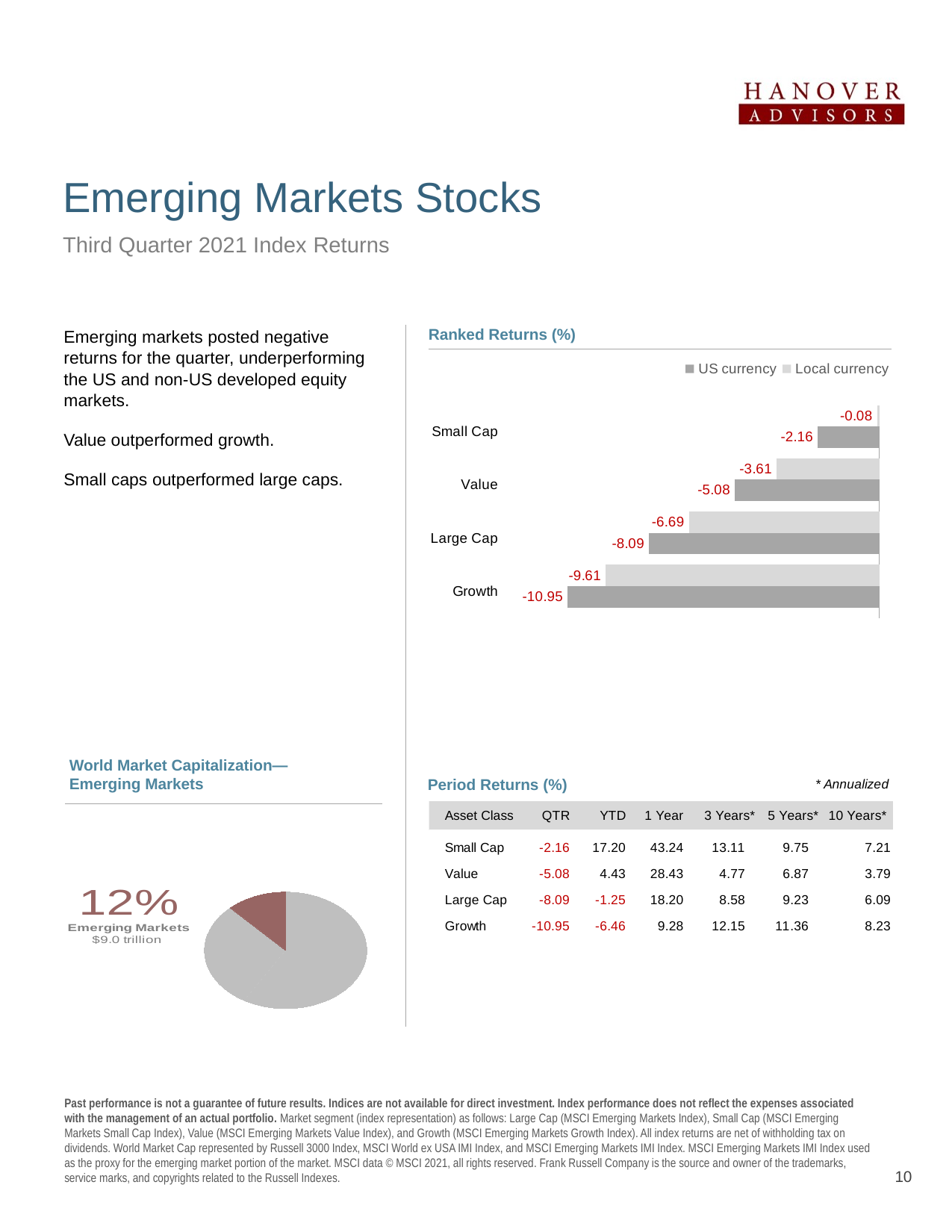
In the Ranked Returns (%) chart, what is the US currency value for Small Cap? -2.16 In the Ranked Returns (%) chart, which category has the highest Local currency value? Small Cap In the Ranked Returns (%) chart, which category has the lowest US currency value? Growth In the World Market Capitalization—Emerging Markets pie chart, what share is labeled for Emerging Markets? 12% In the Ranked Returns (%) chart, what is the difference between the US currency and Local currency values for Large Cap? 1.40 In the Ranked Returns (%) chart, what is the Local currency value for Value? -3.61 What kind of chart is the Ranked Returns (%) chart? Bar chart In the Ranked Returns (%) chart, what is the Local currency value for Growth? -9.61 How many categories are shown in the Ranked Returns (%) chart? 4 In the Ranked Returns (%) chart, which is larger: the US currency value for Value or the US currency value for Growth? Value In the Ranked Returns (%) chart, what is the US currency value for Large Cap? -8.09 How many series does the legend of the Ranked Returns (%) chart list? 2